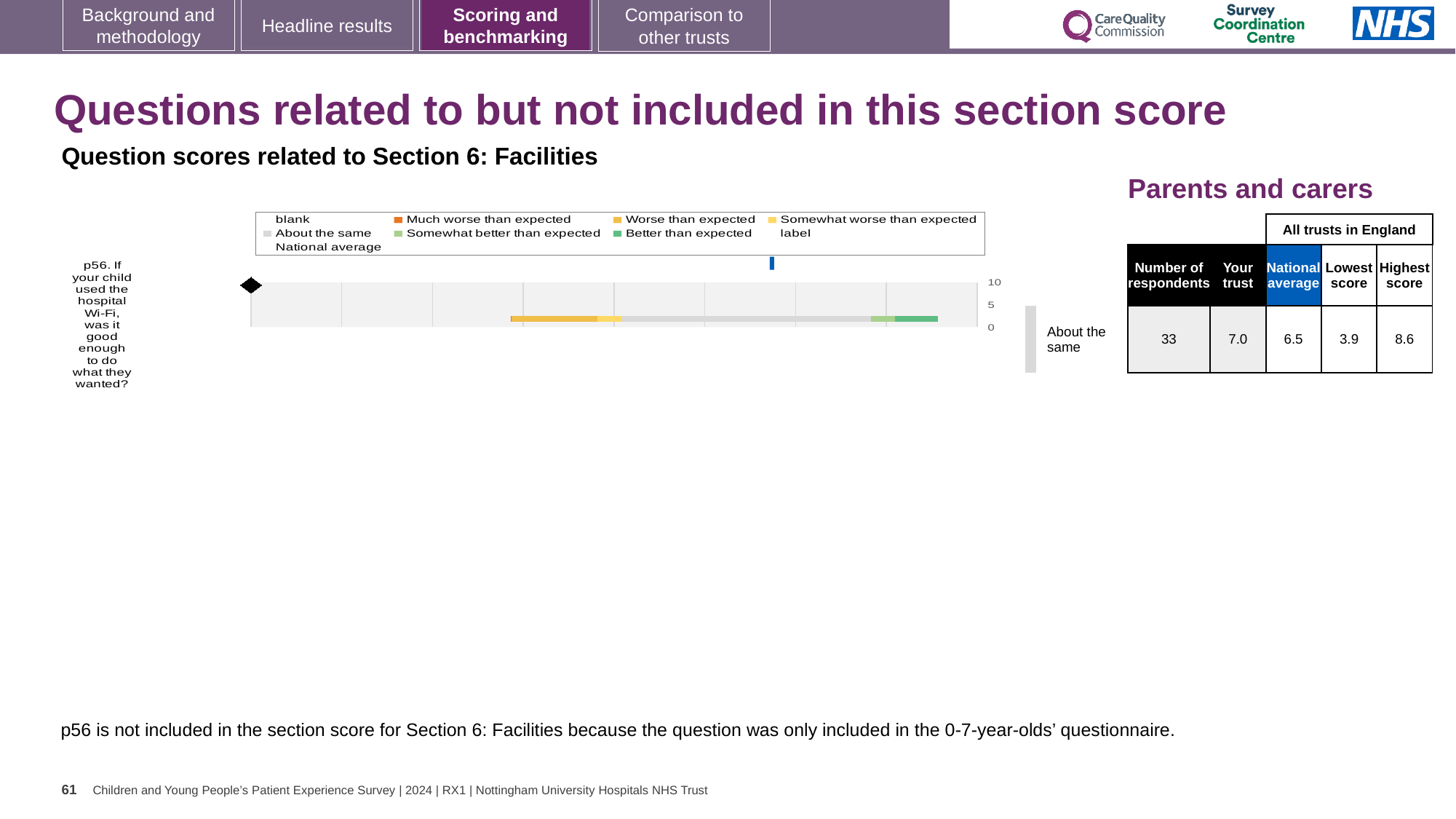
What is the highest score among all trusts in England for p56? 8.6 What kind of chart is used to show the p56 question score? bar chart What is the lowest score among all trusts in England for p56? 3.9 What benchmark category label is shown next to the chart for p56? About the same How many entries does the chart legend list? 9 What is the difference between the highest and lowest scores for p56? 4.7 Which is larger for p56, the 'Your trust' score or the national average? Your trust What is the 'Your trust' score for p56 shown in the table beside the chart? 7.0 How many questions are plotted in the chart? 1 Is the 'Your trust' score for p56 greater or less than 5 on the chart axis? greater How many respondents answered p56? 33 What is the national average score for p56? 6.5